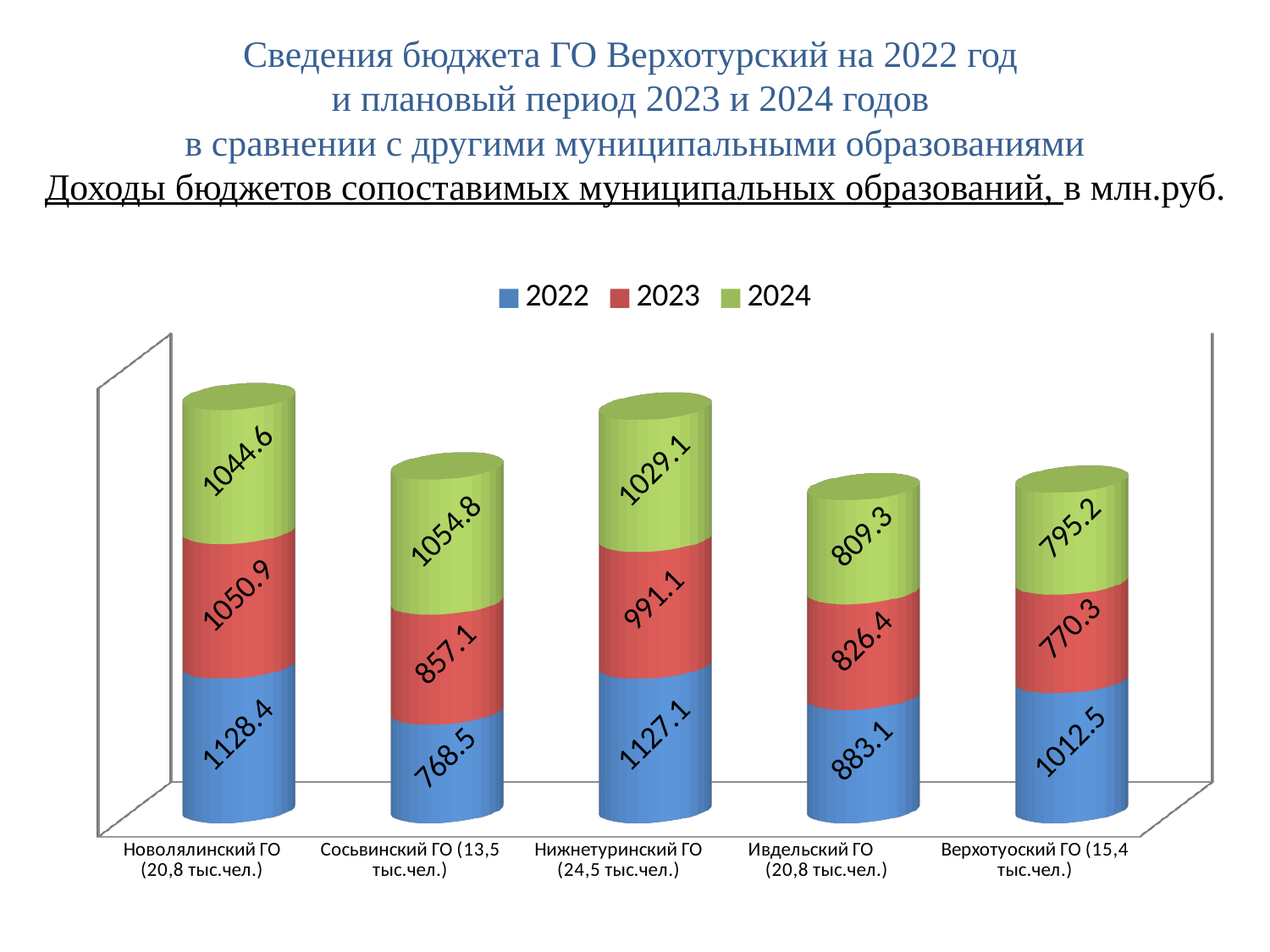
What is the difference between the 2022 and 2023 values for Новолялинский ГО? 77.5 What is the 2023 value for Верхотуоский ГО? 770.3 What is the 2022 value for Сосьвинский ГО? 768.5 What is the total of the stacked bar for Ивдельский ГО? 2518.8 How many series does the legend list? 3 Which municipality has the lowest 2023 value? Верхотуоский ГО What is the 2024 value for Ивдельский ГО? 809.3 What kind of chart is shown on the slide? Stacked bar chart Which is larger: the 2024 value for Нижнетуринский ГО or the 2024 value for Ивдельский ГО? Нижнетуринский ГО Which municipality has the highest 2024 value? Сосьвинский ГО How many municipalities are shown on the chart? 5 Which municipality has the lowest 2022 value? Сосьвинский ГО